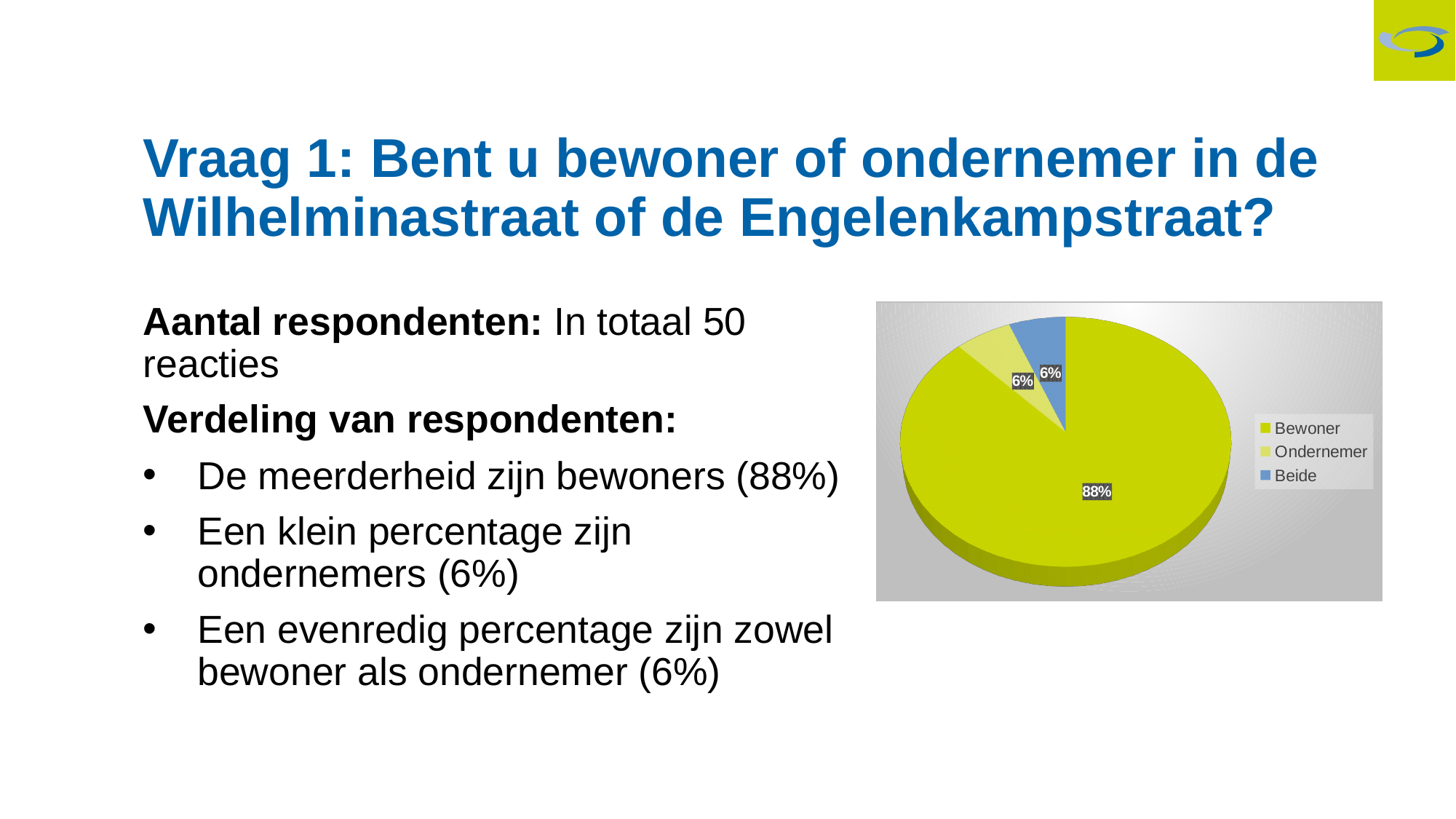
Is the share for Bewoner greater or less than 50%? greater Which is larger, the slice for Bewoner or the slice for Beide? Bewoner How many categories does the legend list? 3 What share of the pie does Beide have? 6% Which legend entry is shown in blue? Beide What share of the pie does Ondernemer have? 6% Which category has the largest slice of the pie? Bewoner What kind of chart is shown on the slide? pie chart What is the difference in percentage points between Bewoner and Ondernemer? 82 What is the combined share of Ondernemer and Beide? 12% What share of the pie does Bewoner have? 88%